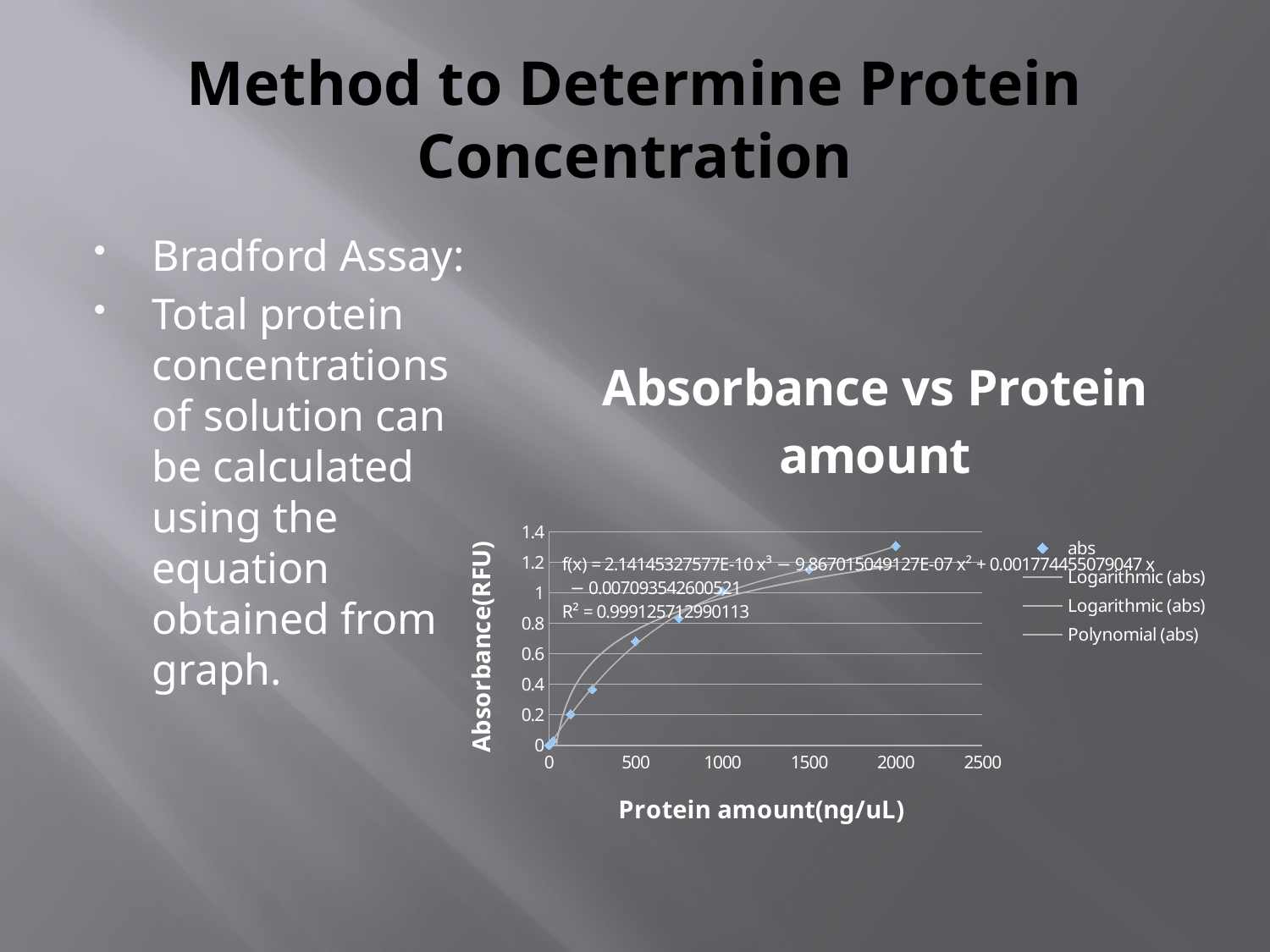
What is the label of the x axis of the chart? Protein amount(ng/uL) Is the absorbance value at a protein amount of 500 greater or less than 0.6? greater At which protein amount is the plotted absorbance highest? 2000 How many entries does the chart's legend list? 4 Do the absorbance values rise or fall as protein amount increases along the x axis? rise Is the absorbance value at a protein amount of 2000 greater or less than 1.2? greater Which has the larger absorbance: the point at protein amount 1500 or the point at 500? 1500 What kind of chart is shown on the slide? scatter chart What is the title of the chart? Absorbance vs Protein amount What R² value is printed on the chart for the fitted polynomial? 0.999125712990113 Is the absorbance value at a protein amount of 250 greater or less than 0.4? less